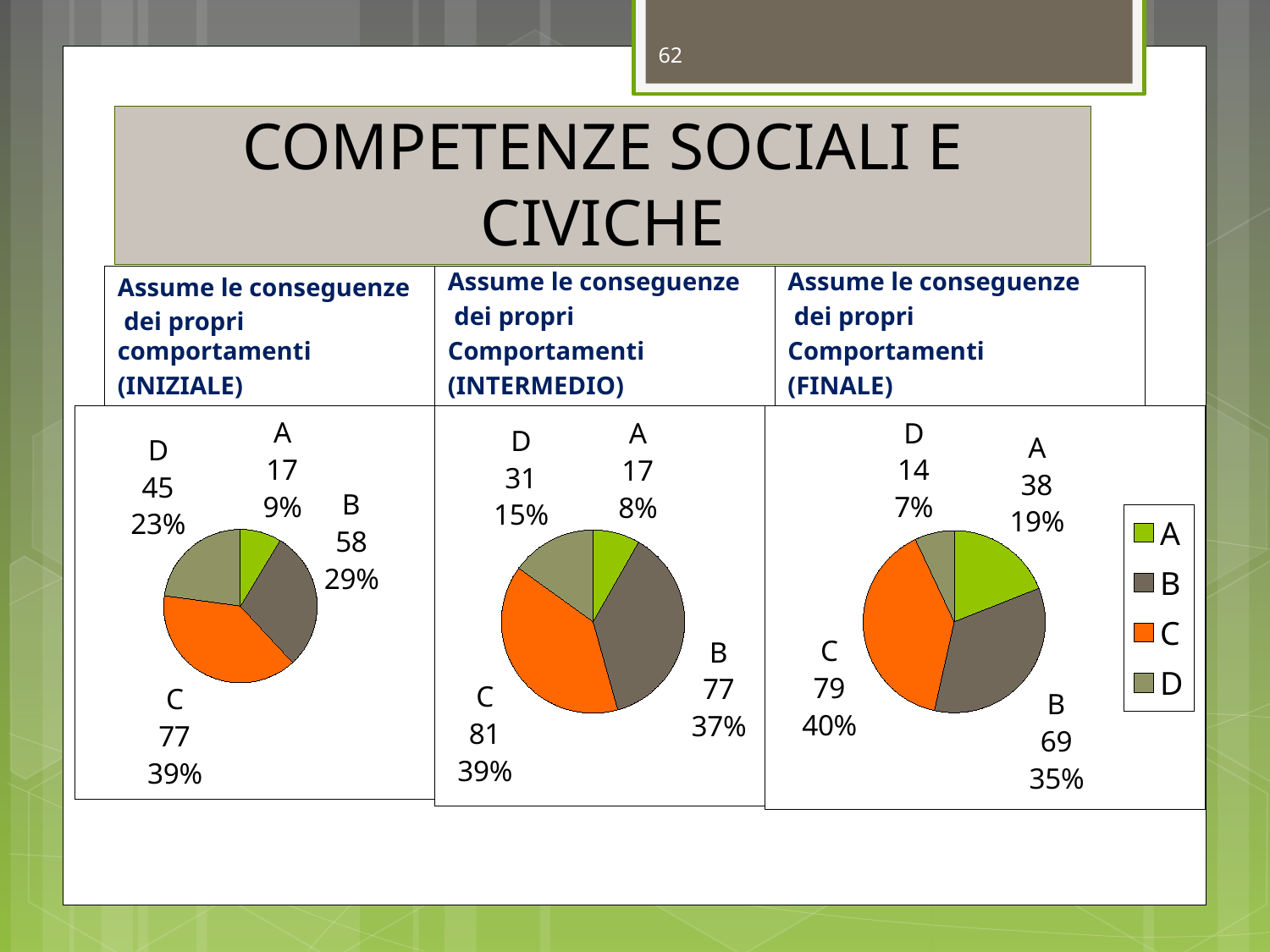
How many entries does the legend on the right of the slide list? 4 What type of chart is used for the FINALE data? Pie chart In the INTERMEDIO pie chart, what is the value for category D? 31 In the INIZIALE pie chart, what is the value for category C? 77 In the INIZIALE pie chart, what percentage share does category B have? 29% In the FINALE pie chart, which category has the smallest slice? D In the legend, which colour represents category C? Orange In the INTERMEDIO pie chart, which category has the largest slice? C In the INTERMEDIO pie chart, which is larger, the value for B or the value for D? B In the FINALE pie chart, what is the difference between the values for C and B? 10 In the FINALE pie chart, what percentage share does category A have? 19% How many categories does the INIZIALE pie chart show? 4